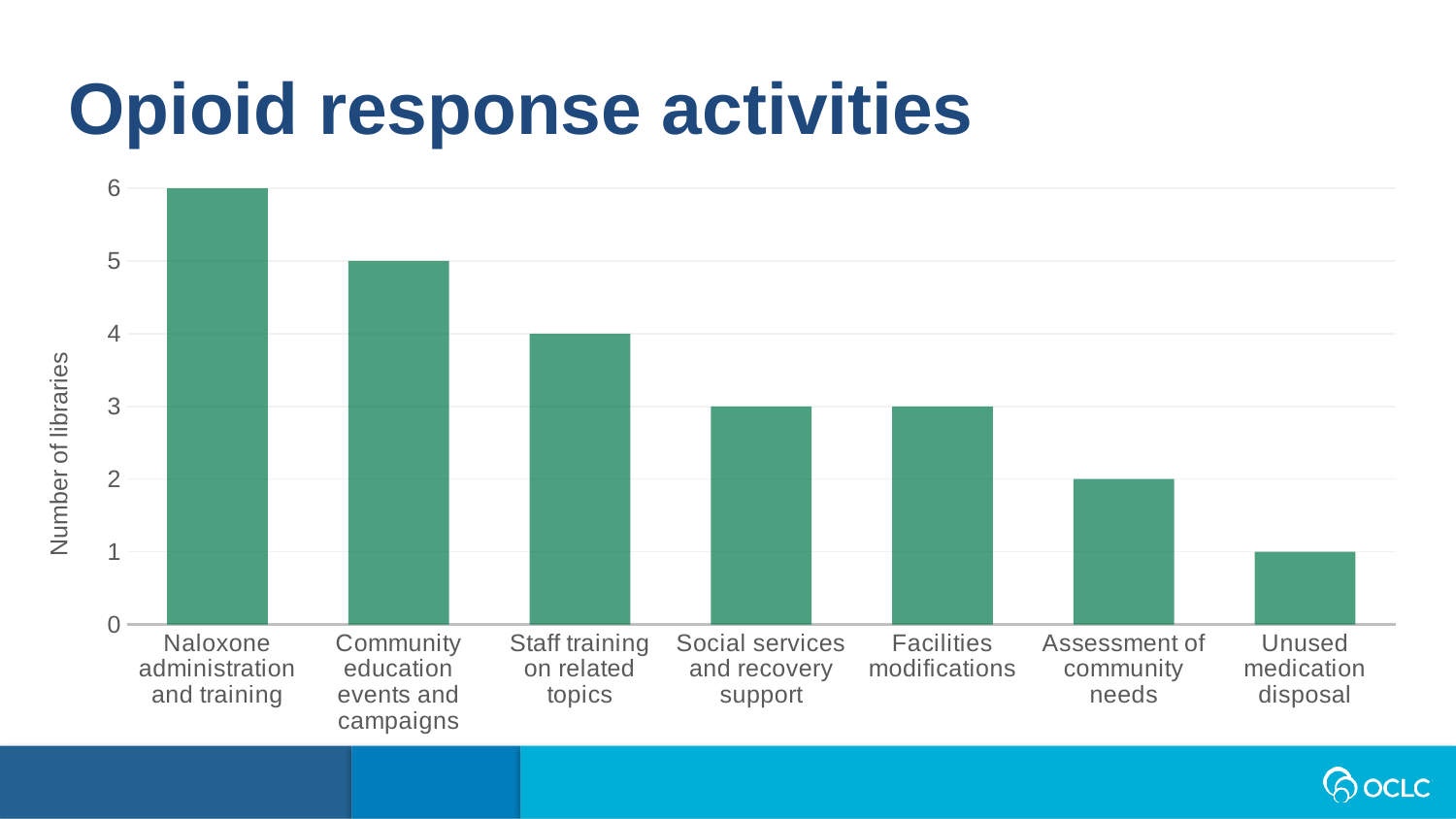
How many activity categories are shown on the chart? 7 What is the difference in number of libraries between Naloxone administration and training and Assessment of community needs? 4 Which activity has the lowest number of libraries? Unused medication disposal How many libraries reported Unused medication disposal? 1 Which has more libraries: Staff training on related topics or Facilities modifications? Staff training on related topics What is the label of the vertical axis? Number of libraries What kind of chart is shown on the slide? bar chart How many libraries reported Naloxone administration and training? 6 Do the values rise or fall moving from left to right along the x axis? fall What is the number of libraries for Staff training on related topics? 4 What is the number of libraries for Community education events and campaigns? 5 Which activity has the highest number of libraries? Naloxone administration and training